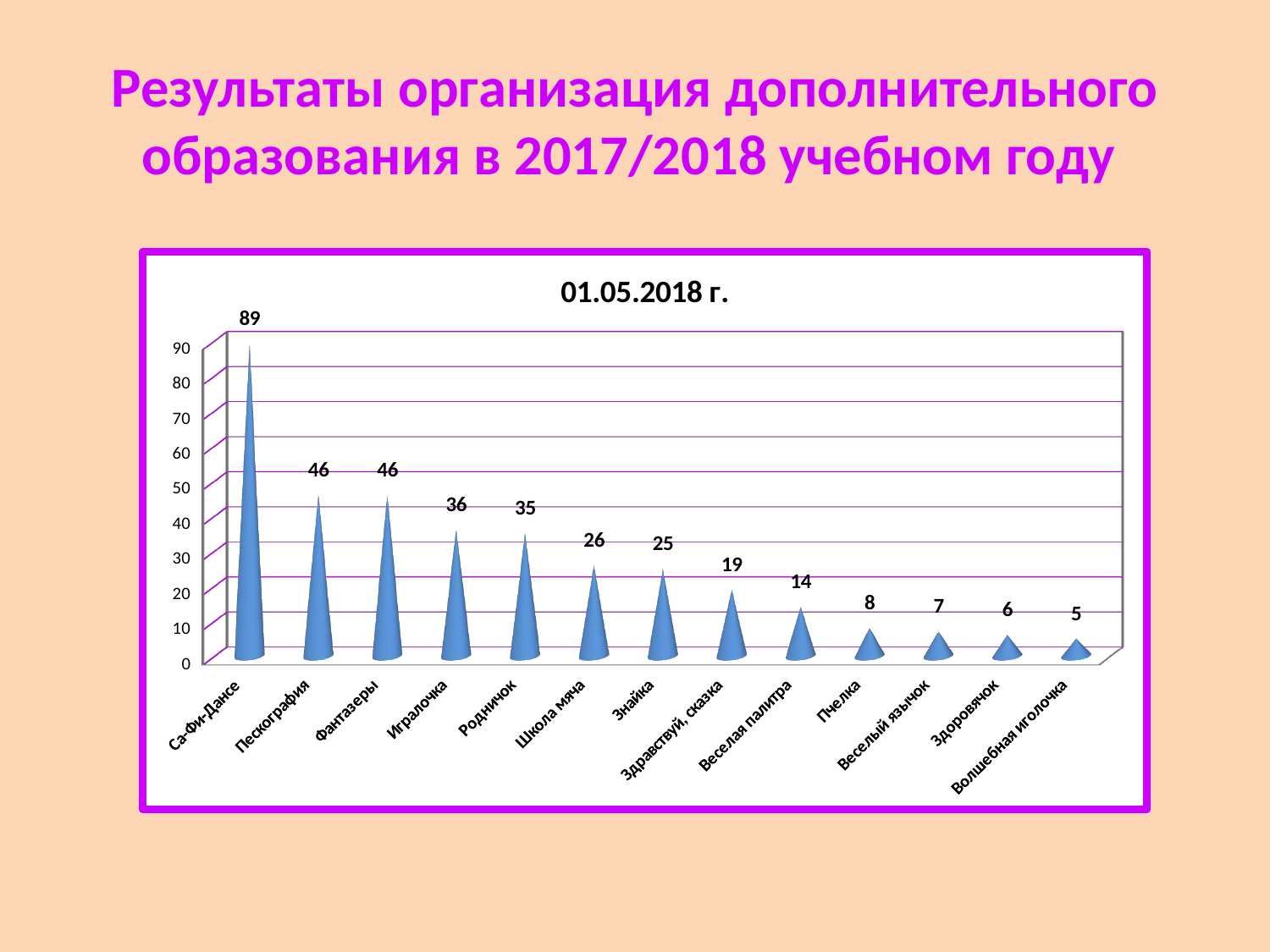
Which category has the lowest value? Волшебная иголочка Is the value for Фантазеры greater or less than 40? greater What kind of chart is shown on the slide? bar chart Which category has the highest value? Са-Фи-Дансе What is the value for Родничок? 35 What is the value for Здравствуй, сказка? 19 Which is larger, the value for Знайка or the value for Веселая палитра? Знайка How many categories are shown on the chart? 13 What is the difference between the values for Игралочка and Школа мяча? 10 What is the difference between the values for Са-Фи-Дансе and Пескография? 43 What is the value for Са-Фи-Дансе? 89 What is the title of the chart? 01.05.2018 г.